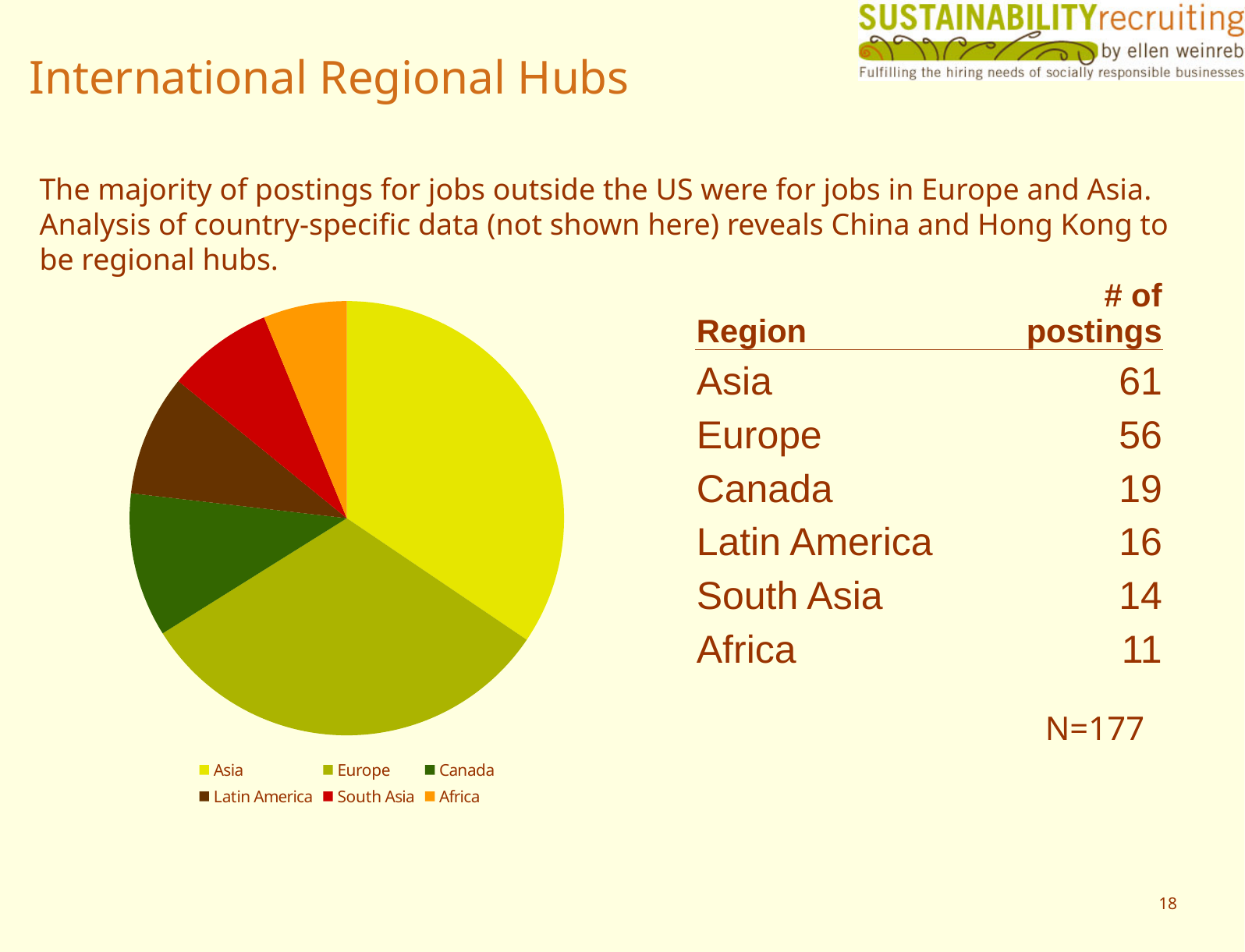
What is the difference in postings between Asia and Europe? 5 Which region has the largest slice of the pie chart? Asia How many postings does the slide show for Asia? 61 How many postings does the slide show for Canada? 19 What kind of chart is shown on the slide? pie chart Which region has the smallest slice of the pie chart? Africa How many postings does the slide show for Europe? 56 What colour is the Asia slice in the pie chart? yellow Which has more postings, Latin America or South Asia? Latin America What is the total number of postings across all regions in the pie chart? 177 How many postings does the slide show for Africa? 11 How many regions does the pie chart's legend list? 6